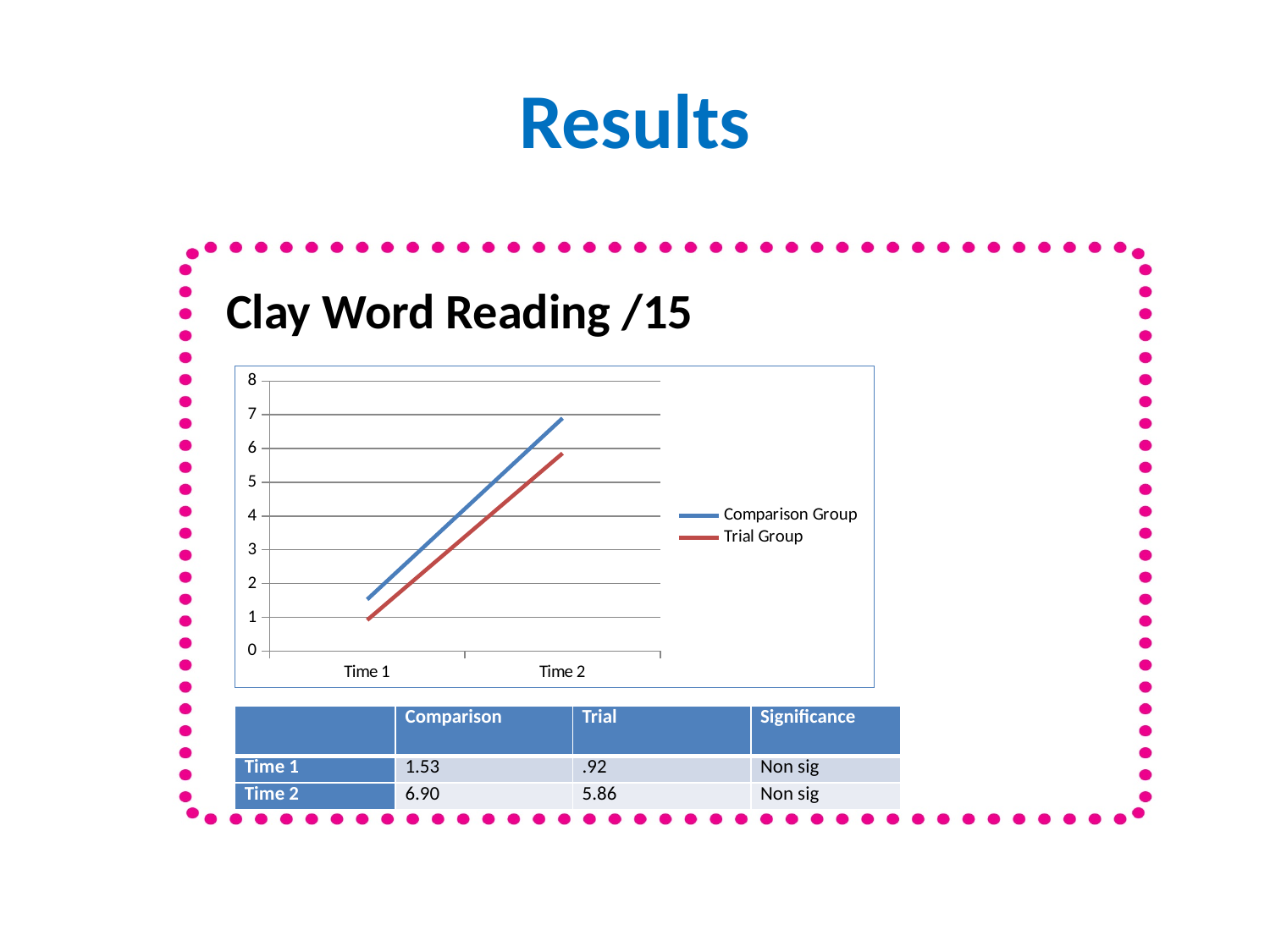
According to the table, what is the Comparison group's value at Time 2? 6.90 Which series has the higher value at Time 2, Comparison Group or Trial Group? Comparison Group How many series does the chart legend list? 2 Do the values for the Trial Group rise or fall from Time 1 to Time 2? rise Which series is shown in blue in the chart? Comparison Group What is the heading above the chart? Clay Word Reading /15 According to the table, what is the Trial group's value at Time 2? 5.86 What kind of chart is shown on the slide? line chart According to the table, what is the Comparison group's value at Time 1? 1.53 Is the Comparison Group value at Time 2 greater or less than 6? greater How many time points are plotted on the x axis of the chart? 2 Is the Trial Group value at Time 1 greater or less than 2? less